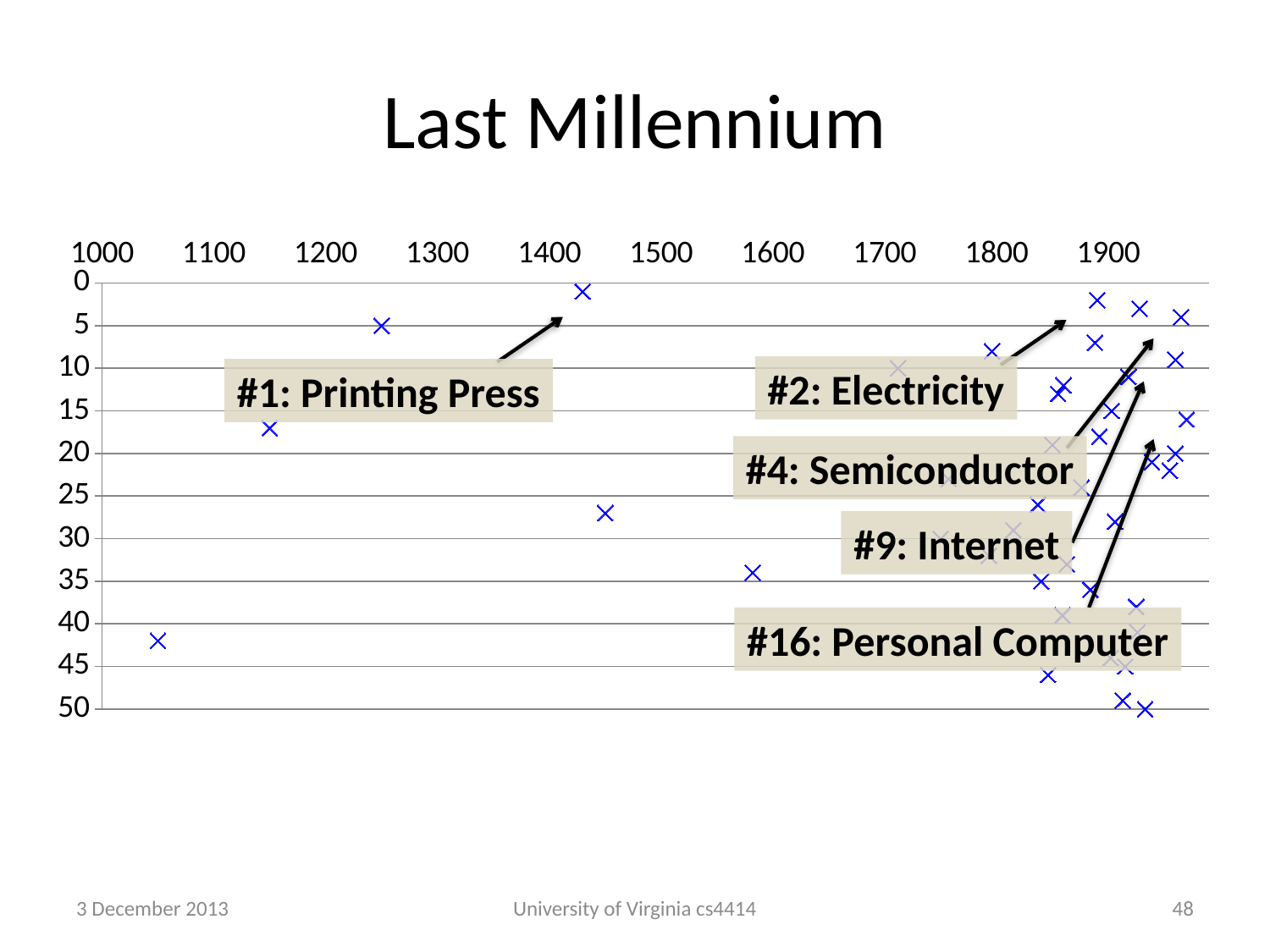
Is the year of the point labelled #2: Electricity greater or less than 1800? greater Which invention is labelled #1 on the chart? Printing Press Is the year of the point labelled #16: Personal Computer greater or less than 1900? greater What kind of chart is shown on the slide? scatter chart What is the title of the chart? Last Millennium Is the y-axis value of the leftmost point on the chart greater or less than 30? greater Of the labelled inventions, which has the earliest year on the x axis? Printing Press Which labelled invention is earlier on the x axis, Printing Press or Electricity? Printing Press